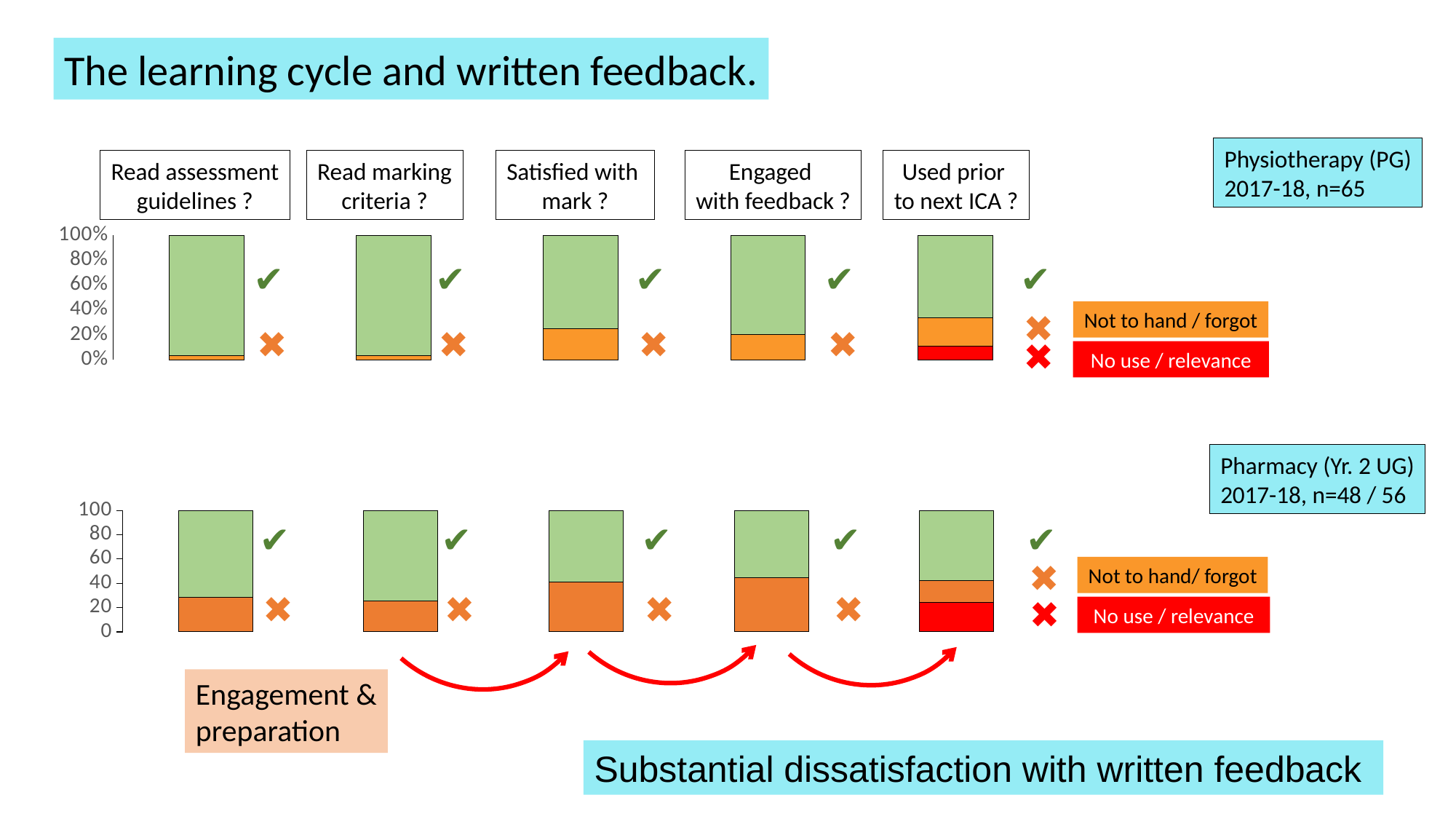
In the Physiotherapy (PG) chart, is the orange segment for 'Satisfied with mark ?' greater or less than 40%? less In the Physiotherapy (PG) chart, is the red segment for 'Used prior to next ICA ?' greater or less than 20%? less In the Physiotherapy (PG) chart, is the green segment for 'Used prior to next ICA ?' greater or less than 40%? greater In the Pharmacy (Yr. 2 UG) chart, how many bars are plotted? 5 In the Physiotherapy (PG) chart, which category has the smallest green segment? Used prior to next ICA ? What kind of chart is used on this slide to show the survey responses? bar chart In the Physiotherapy (PG) chart, how many bars are plotted? 5 In the Physiotherapy (PG) chart, which has the larger orange segment: 'Satisfied with mark ?' or 'Read assessment guidelines ?'? Satisfied with mark ? According to the legend, what does the red colour represent? No use / relevance In the Pharmacy (Yr. 2 UG) chart, which has the larger orange segment: 'Engaged with feedback ?' or 'Read marking criteria ?'? Engaged with feedback ?